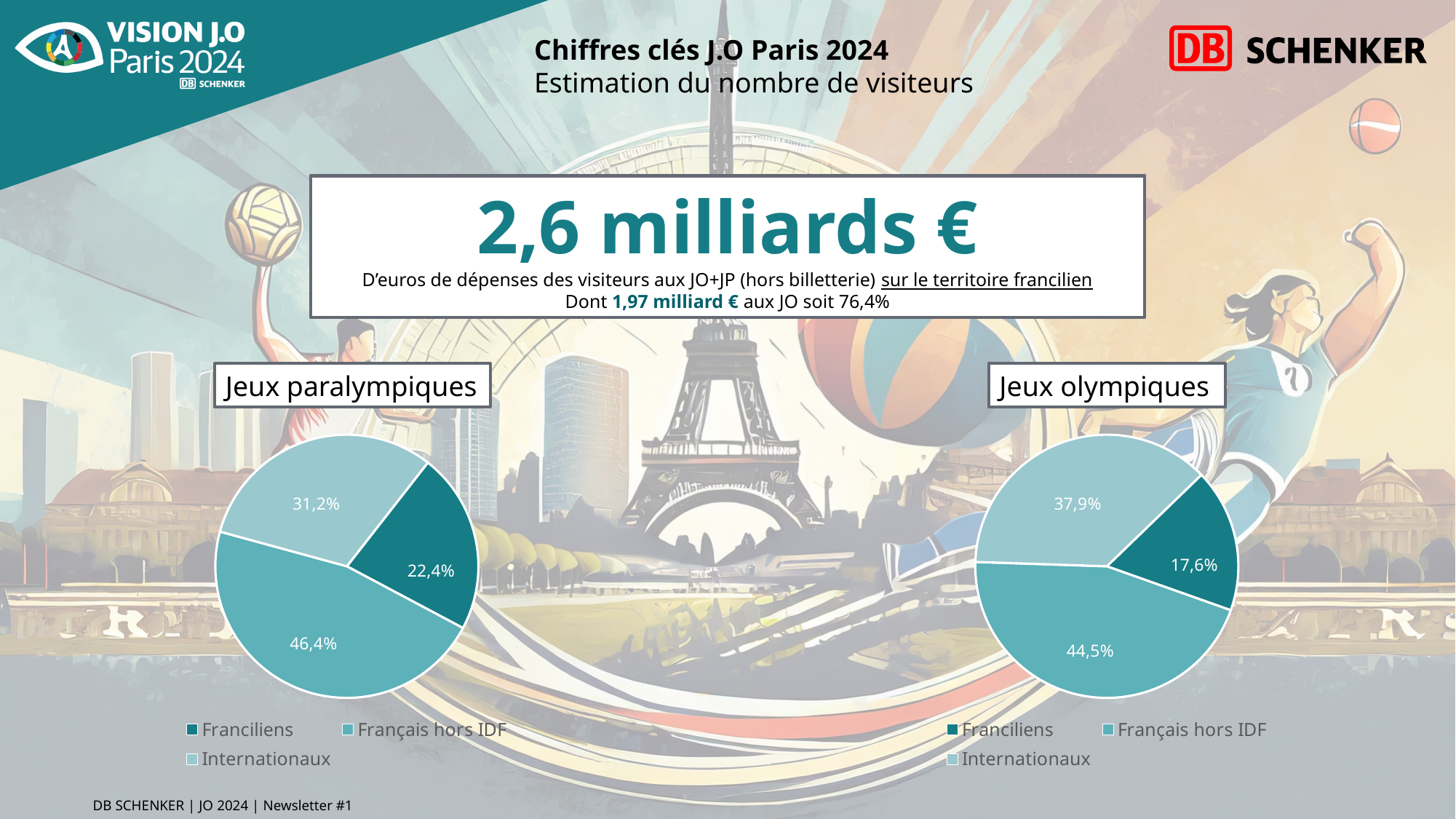
What type of chart is used for 'Jeux olympiques'? Pie chart In the 'Jeux paralympiques' pie chart, which category has the largest share? Français hors IDF In the 'Jeux olympiques' pie chart, what share is shown for Internationaux? 37,9% In the 'Jeux paralympiques' pie chart, which category is shown in the darkest teal colour? Franciliens In the 'Jeux paralympiques' pie chart, what share is shown for Français hors IDF? 46,4% In the 'Jeux paralympiques' pie chart, what share is shown for Franciliens? 22,4% How many entries does the legend of the 'Jeux olympiques' chart list? 3 How many categories does the 'Jeux paralympiques' pie chart show? 3 In the 'Jeux olympiques' pie chart, which category has the smallest share? Franciliens In the 'Jeux olympiques' pie chart, what share is shown for Franciliens? 17,6% Which is larger: the Franciliens share in the 'Jeux paralympiques' chart or the Franciliens share in the 'Jeux olympiques' chart? Jeux paralympiques In the 'Jeux olympiques' pie chart, what is the difference between the shares of Français hors IDF and Internationaux? 6,6%